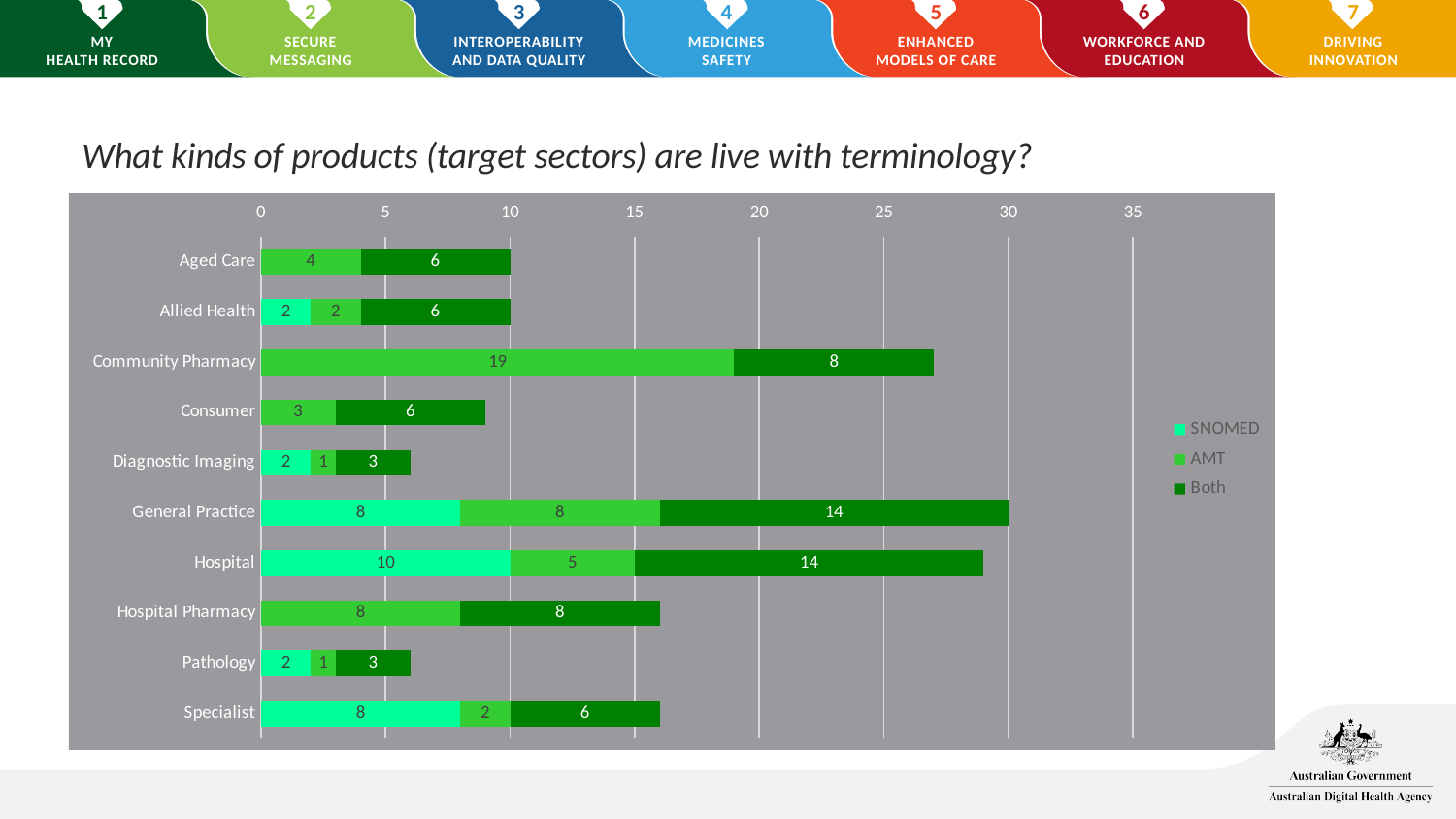
What kind of chart is shown on the slide? Stacked bar chart What is the title of the chart? What kinds of products (target sectors) are live with terminology? Which category has the longest stacked bar overall? General Practice What is the SNOMED value for Hospital? 10 How many series does the legend list? 3 Is the total bar for Community Pharmacy greater or less than 25? greater What is the 'Both' value for Community Pharmacy? 8 What is the total of the stacked bar for Hospital? 29 What is the total of the stacked bar for General Practice? 30 Which has the larger total bar, Community Pharmacy or Hospital? Hospital How many target sector categories are plotted on the chart? 10 What is the difference between the 'Both' value for General Practice and the 'Both' value for Specialist? 8